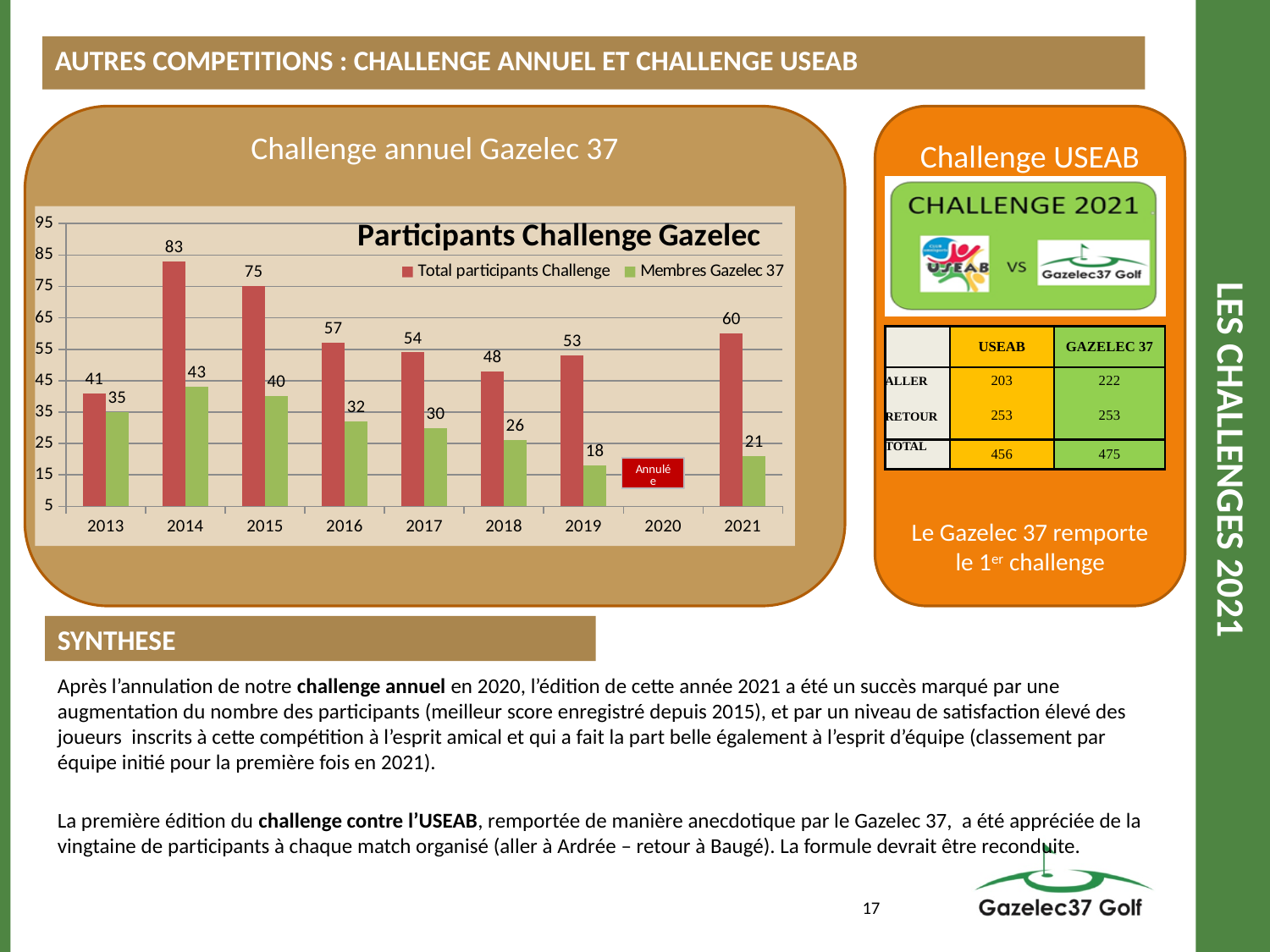
Which year has the lowest value for Membres Gazelec 37? 2019 What kind of chart is shown? Bar chart What is the value for Total participants Challenge in 2021? 60 What is the value for Membres Gazelec 37 in 2019? 18 What label is shown for the year 2020 instead of bars? Annulée What is the difference between Total participants Challenge and Membres Gazelec 37 in 2021? 39 Which year has the highest value for Total participants Challenge? 2014 What is the title of the chart? Participants Challenge Gazelec What is the value for Total participants Challenge in 2014? 83 Which is larger: Total participants Challenge in 2016 or in 2017? 2016 How many series does the legend list? 2 Does the value for Membres Gazelec 37 rise or fall from 2015 to 2019? Fall